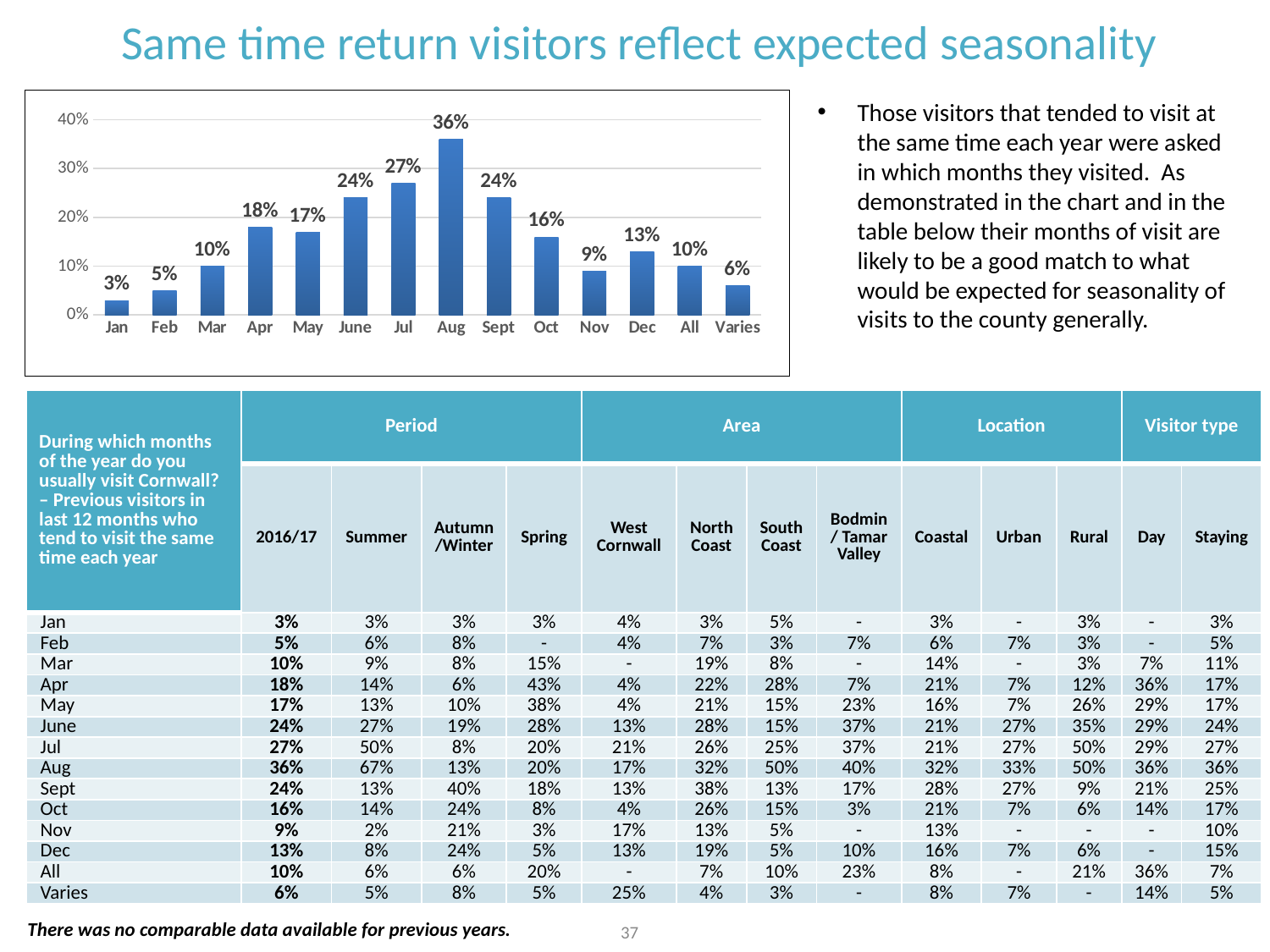
How many categories are shown on the x axis of the chart? 14 What kind of chart is shown on the slide? bar chart Which is larger in the chart, the value for Apr or the value for May? Apr Do the values rise or fall from Jan to Aug in the chart? rise Is the value for Jul greater or less than 20%? greater What is the difference between the values for Aug and Jul in the chart? 9% Which category has the lowest value in the chart? Jan What is the value for Sept in the chart? 24% What is the value for Aug in the chart? 36% What is the value for Jan in the chart? 3% What is the difference between the values for Dec and Nov in the chart? 4% Which category has the highest value in the chart? Aug